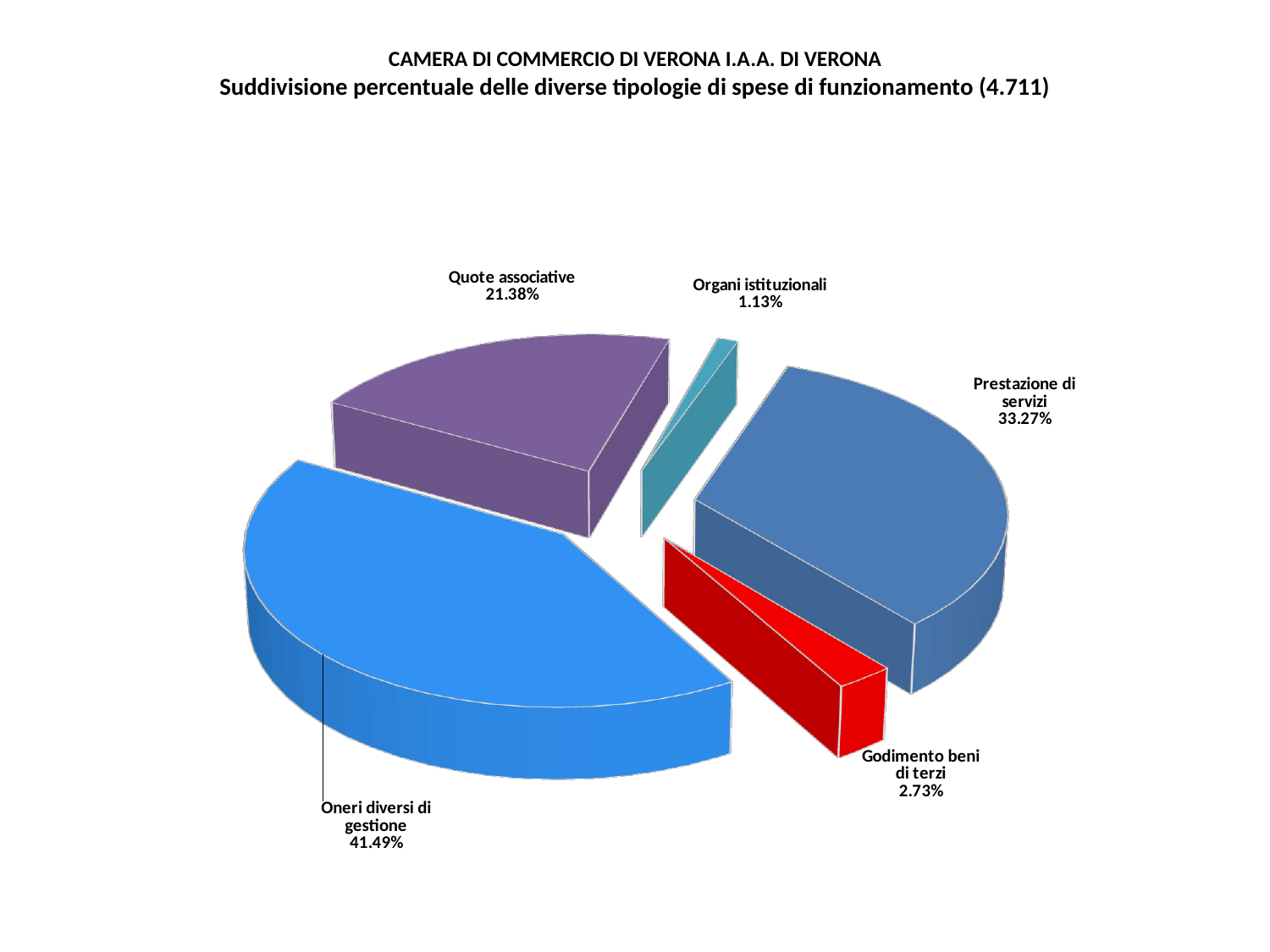
What share of the pie does Oneri diversi di gestione represent? 41.49% How many categories are shown in the pie chart? 5 Which category has the largest slice of the pie? Oneri diversi di gestione What percentage is shown for Quote associative? 21.38% What is the difference in percentage points between Oneri diversi di gestione and Prestazione di servizi? 8.22 Which category has the smallest slice of the pie? Organi istituzionali What kind of chart is shown on the slide? Pie chart What is the value for Godimento beni di terzi? 2.73% What colour is the slice for Godimento beni di terzi? Red What is the value shown for Prestazione di servizi? 33.27% What is the value for Organi istituzionali? 1.13% Which is larger, Quote associative or Prestazione di servizi? Prestazione di servizi